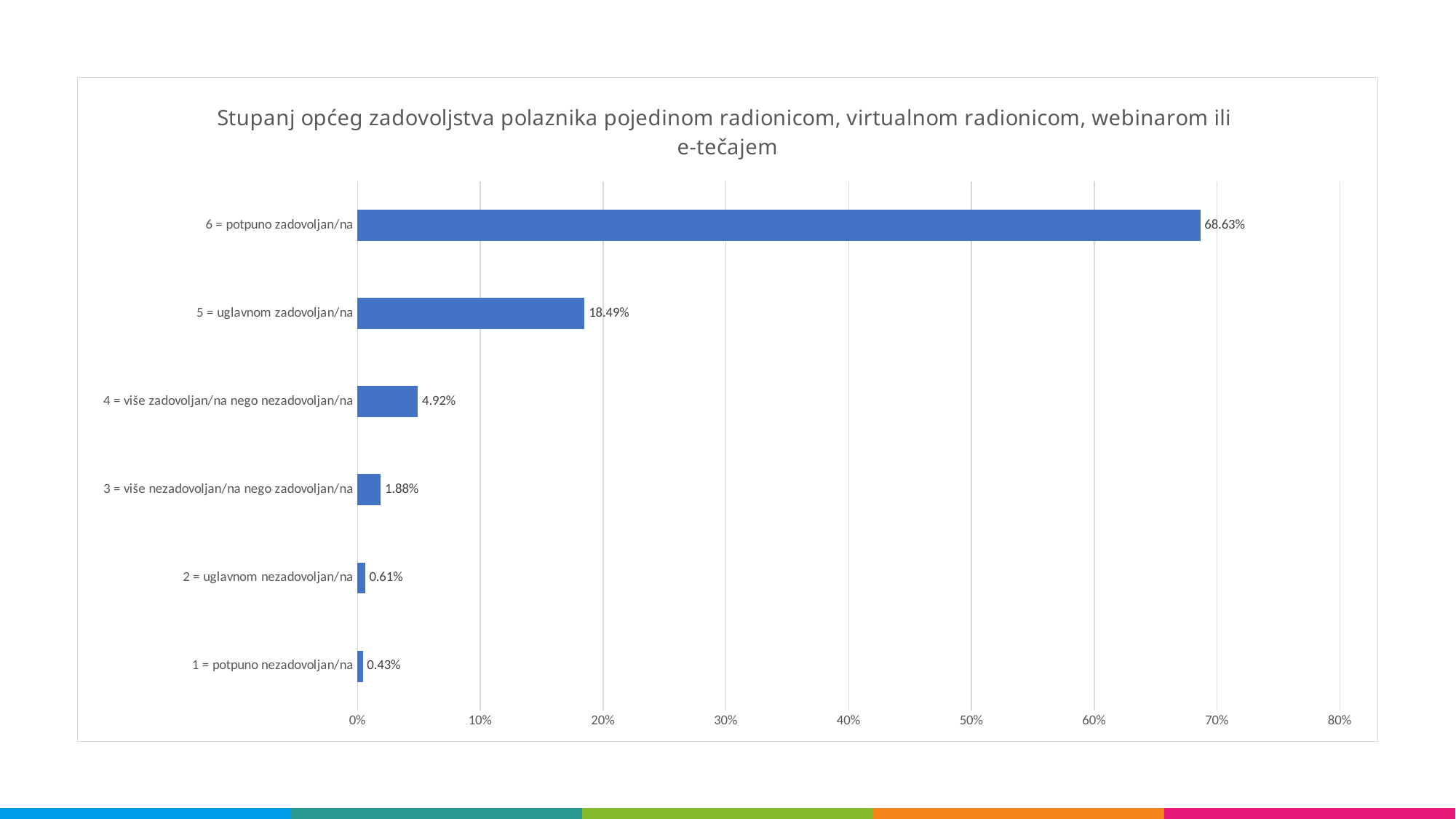
What is the value for "5 = uglavnom zadovoljan/na"? 18.49% What kind of chart is shown on the slide? bar chart Which category has the lowest value? 1 = potpuno nezadovoljan/na What is the value for "1 = potpuno nezadovoljan/na"? 0.43% Which category has the highest value? 6 = potpuno zadovoljan/na How many categories are shown in the chart? 6 What is the value for "4 = više zadovoljan/na nego nezadovoljan/na"? 4.92% Which is larger, the value for "3 = više nezadovoljan/na nego zadovoljan/na" or "2 = uglavnom nezadovoljan/na"? 3 = više nezadovoljan/na nego zadovoljan/na What is the difference between the values for "6 = potpuno zadovoljan/na" and "5 = uglavnom zadovoljan/na"? 50.14% What is the value for "6 = potpuno zadovoljan/na"? 68.63% What is the maximum value shown on the horizontal axis? 80% Is the value for "5 = uglavnom zadovoljan/na" greater or less than 20%? less